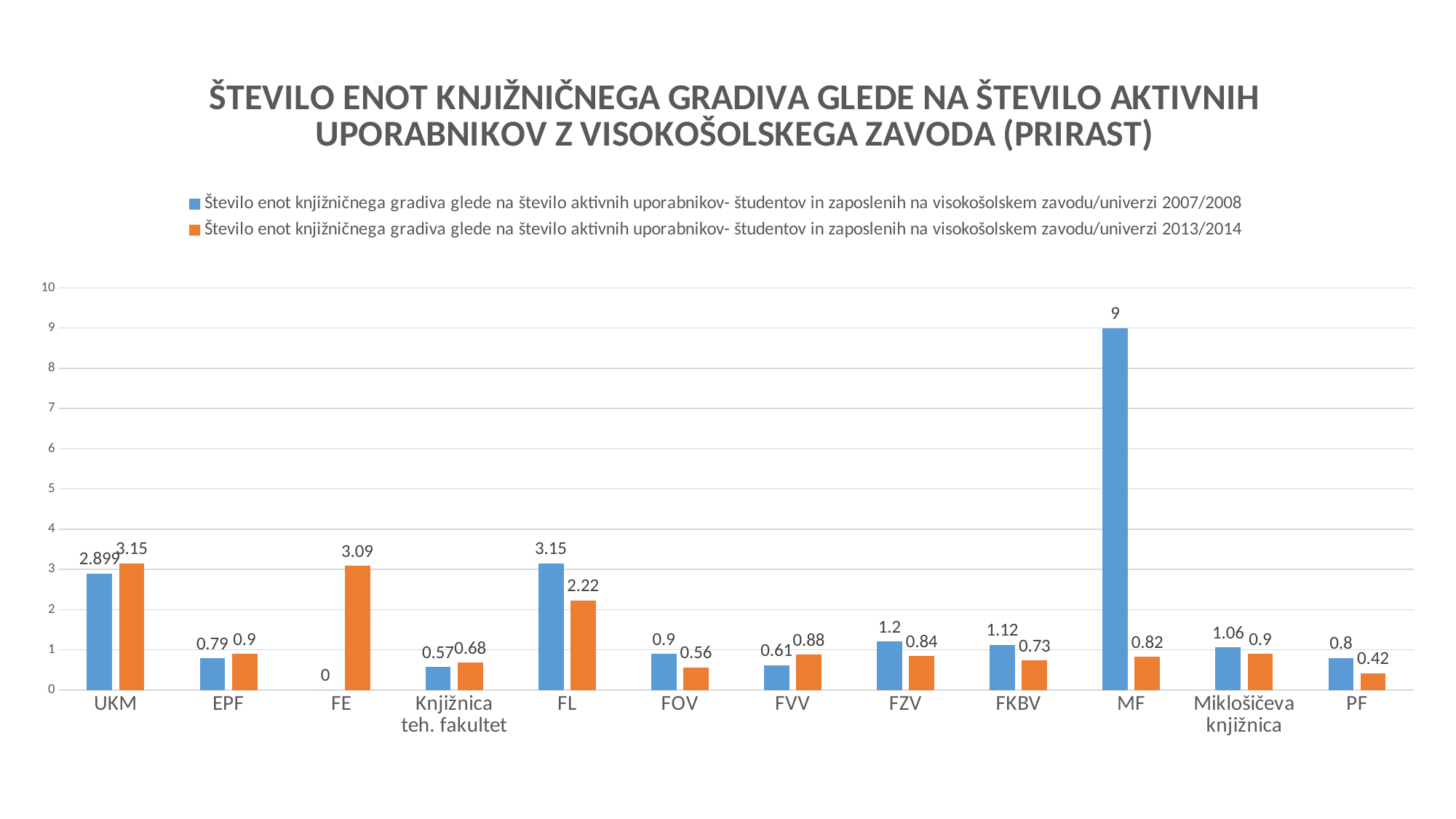
How many categories are shown on the x axis? 12 What kind of chart is shown on the slide? Bar chart What is the 2013/2014 value for FE? 3.09 How many series does the legend list? 2 What is the 2007/2008 value for MF? 9 Which is larger for FL: the 2007/2008 value or the 2013/2014 value? 2007/2008 What is the difference between the 2007/2008 and 2013/2014 values for MF? 8.18 Which category has the highest 2007/2008 value? MF Which category has the lowest 2007/2008 value? FE What is the 2007/2008 value for UKM? 2.899 Which category has the lowest 2013/2014 value? PF What is the 2013/2014 value for PF? 0.42